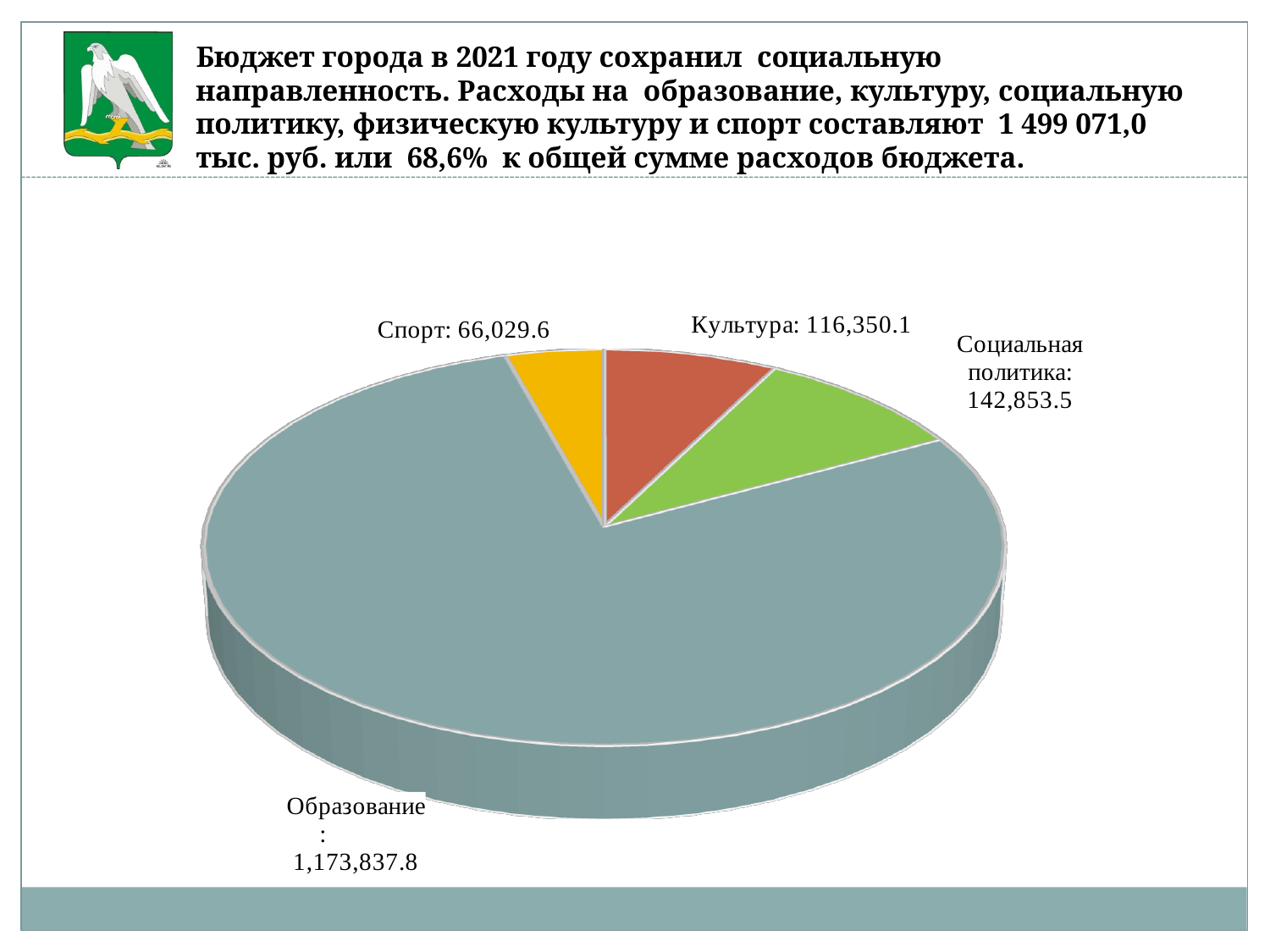
What value is shown for Социальная политика in the pie chart? 142,853.5 What value is shown for Культура in the pie chart? 116,350.1 What is the difference between the values for Культура and Спорт? 50,320.5 What share of the pie does Образование represent, to one decimal place? 78.3% What value is shown for Спорт in the pie chart? 66,029.6 Which category has the largest slice in the pie chart? Образование What type of chart is shown on the slide? Pie chart Which category has the smallest slice in the pie chart? Спорт Which is larger, the value for Культура or the value for Социальная политика? Социальная политика What value is shown for Образование in the pie chart? 1,173,837.8 How many slices does the pie chart have? 4 What is the difference between the values for Социальная политика and Культура? 26,503.4